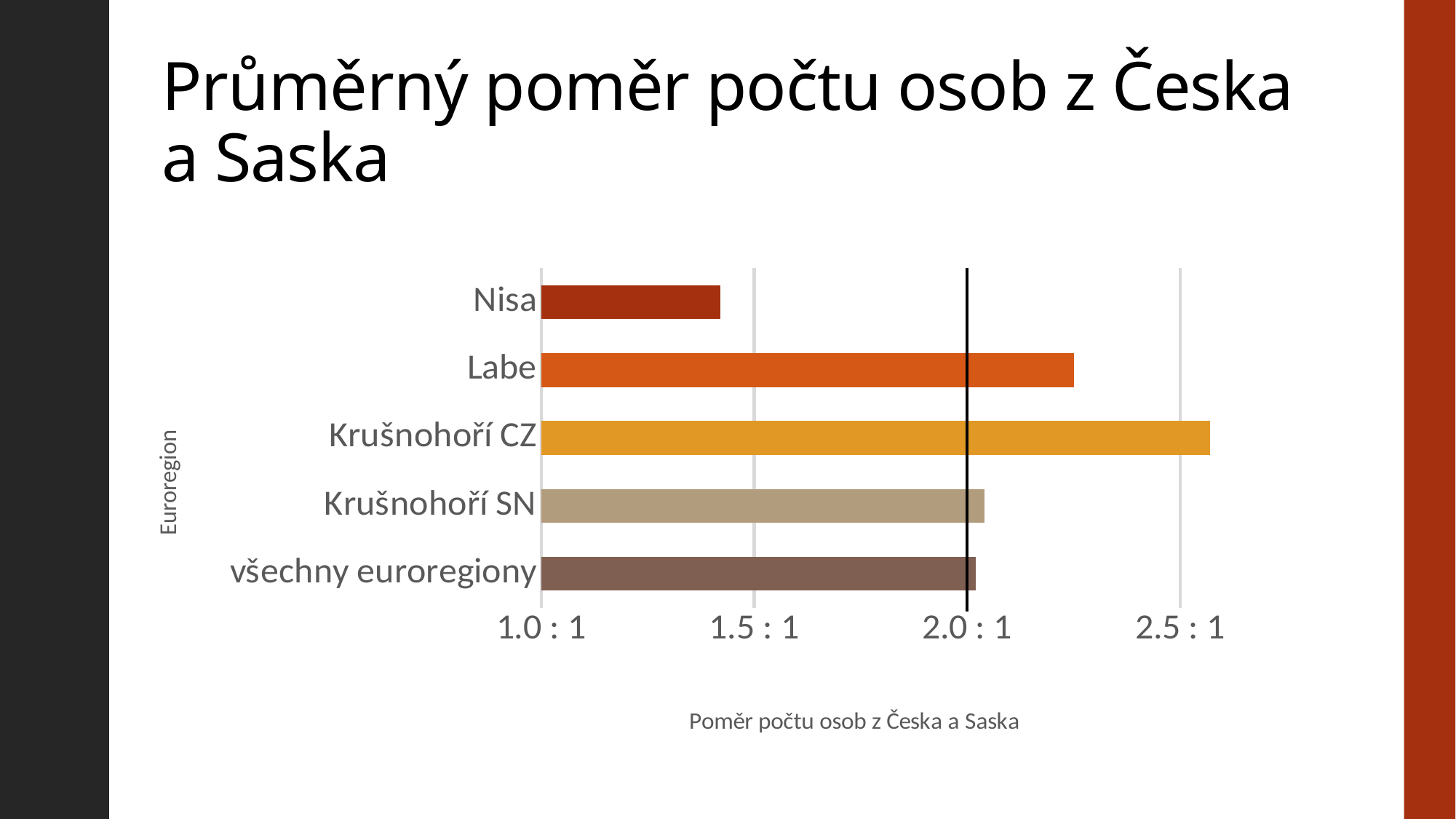
Is the value for Nisa greater or less than 1.5 : 1? less Which euroregion has the lowest ratio in the chart? Nisa What kind of chart is shown on the slide? bar chart Is the value for všechny euroregiony greater or less than 1.5 : 1? greater Is the value for Krušnohoří CZ greater or less than 2.5 : 1? greater Which euroregion has the highest ratio in the chart? Krušnohoří CZ Which has a larger ratio, Krušnohoří CZ or Krušnohoří SN? Krušnohoří CZ What is the title of the horizontal axis of the chart? Poměr počtu osob z Česka a Saska Which has a larger ratio, Labe or Nisa? Labe How many euroregion categories are plotted in the chart? 5